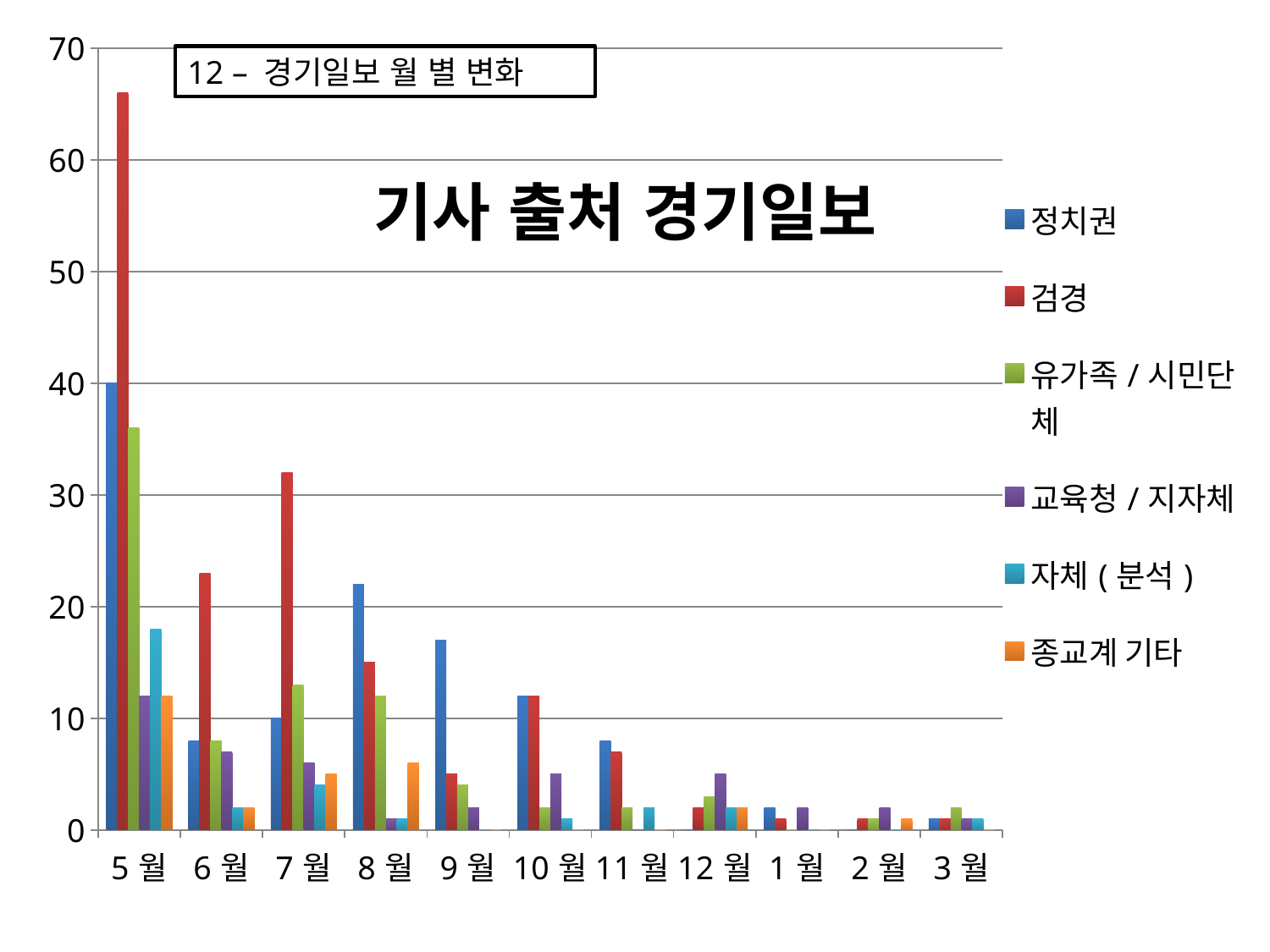
How many series does the legend list? 6 Which series has the highest bar in 9 월? 정치권 How many months are shown along the x axis? 11 In 5 월, which is larger: 정치권 or 유가족 / 시민단체? 정치권 Is the value for 자체 ( 분석 ) in 5 월 greater or less than 20? less Is the value for 정치권 in 8 월 greater or less than 20? greater Is the value for 검경 in 6 월 greater or less than 20? greater What is the title of the chart? 기사 출처 경기일보 In which month is the 검경 bar the highest? 5 월 What kind of chart is shown on the slide? bar chart In 7 월, which is larger: 검경 or 정치권? 검경